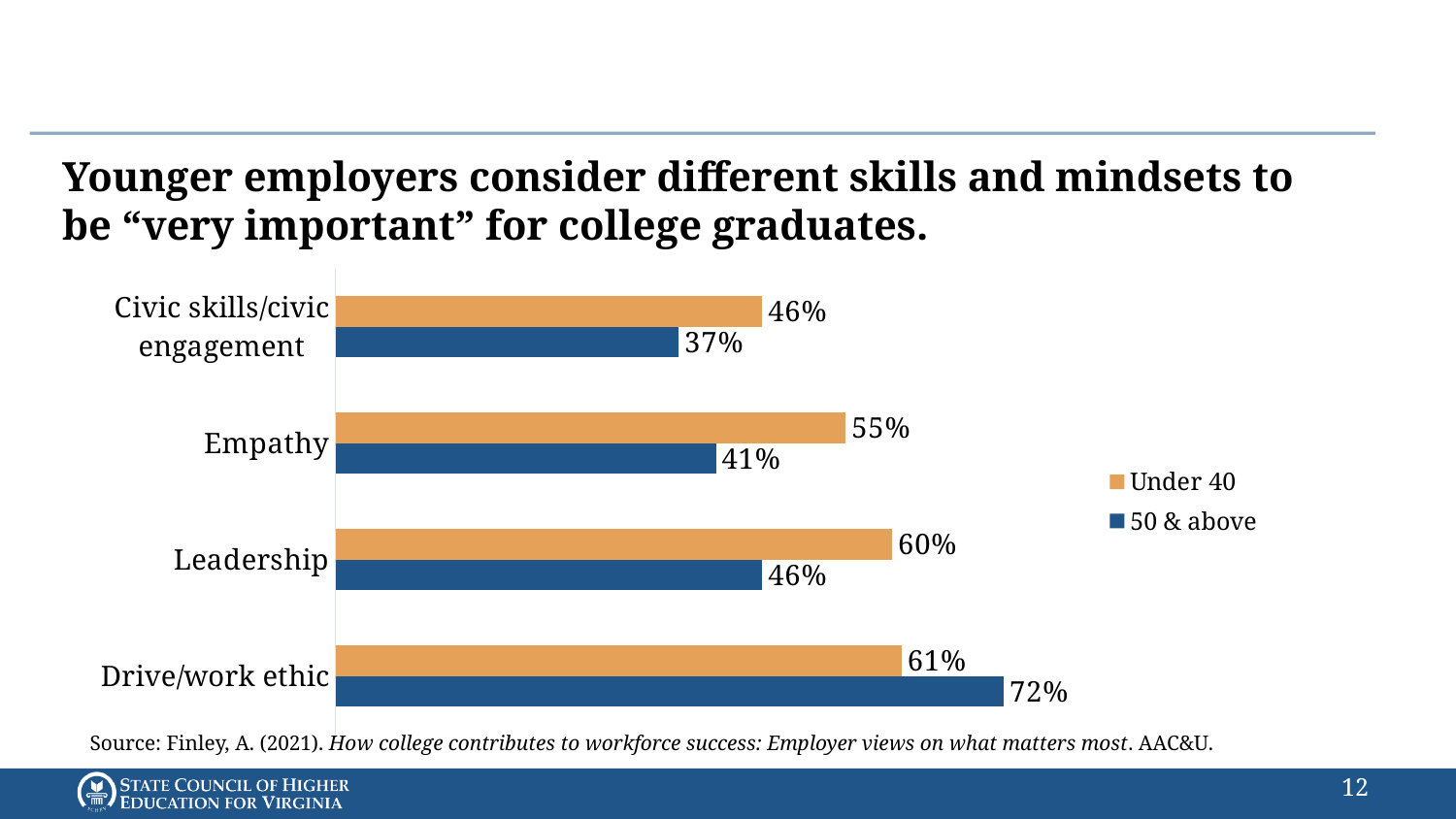
For Drive/work ethic, which group has the larger value, Under 40 or 50 & above? 50 & above What percentage of employers under 40 consider empathy very important? 55% What is the value for Under 40 for Civic skills/civic engagement? 46% For Leadership, which group has the larger value, Under 40 or 50 & above? Under 40 What type of chart is shown on the slide? Bar chart Which category has the lowest value for the Under 40 series? Civic skills/civic engagement Which colour represents the Under 40 series? Orange How many series does the legend list? 2 What is the value for 50 & above for Drive/work ethic? 72% What is the difference between the Under 40 and 50 & above values for Empathy? 14 percentage points How many skill categories are shown in the chart? 4 Which category has the highest value for the 50 & above series? Drive/work ethic